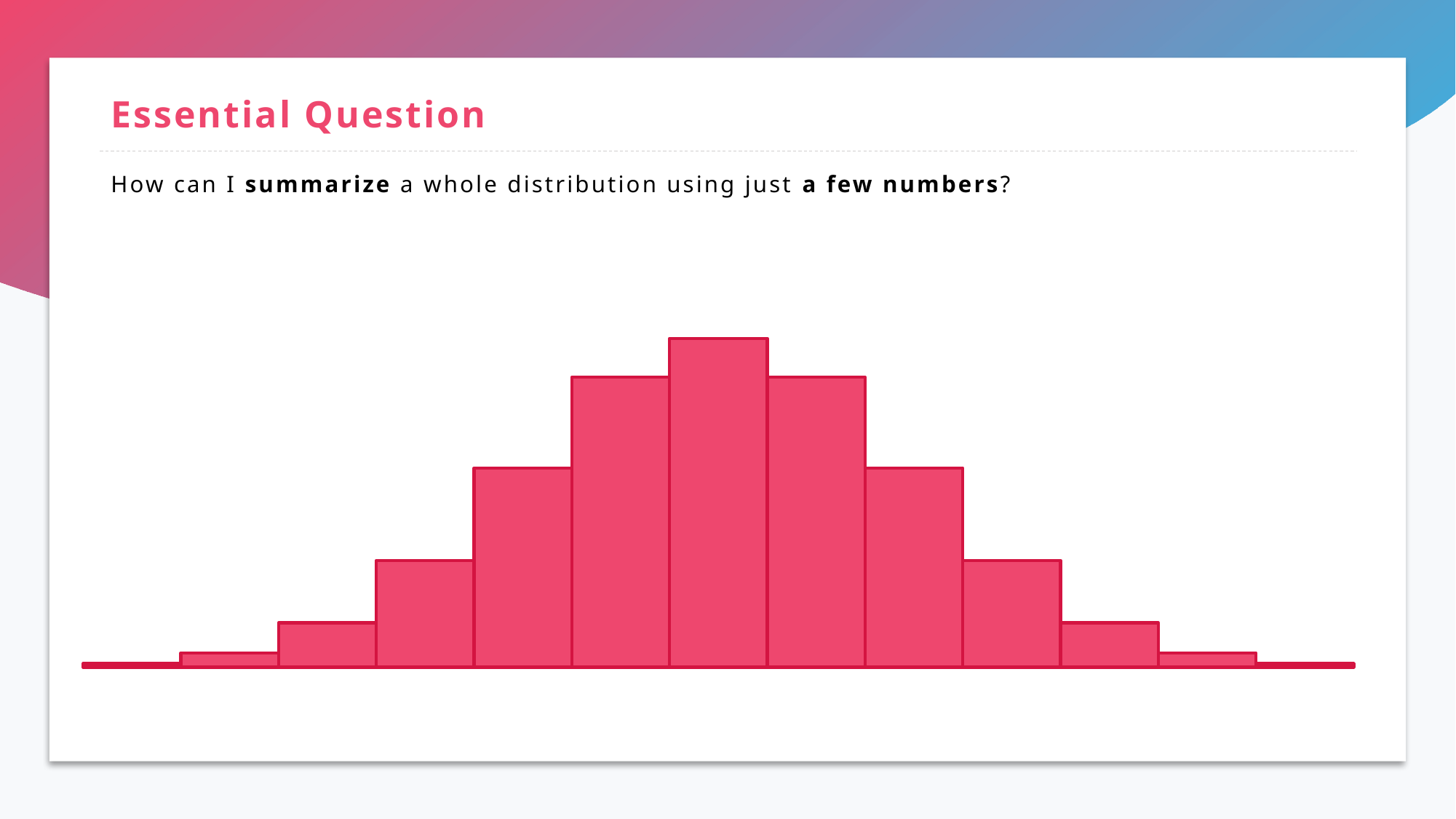
Do the bar heights rise or fall moving from the middle of the chart toward the right edge? Fall How many bars does the chart contain? 11 What colour are the bars in the chart? Pink/red Is the fourth bar from the left taller or shorter than the third bar from the left? Taller What kind of chart is shown on the slide? Bar chart Do the bar heights rise or fall moving from the left edge toward the middle of the chart? Rise Does the chart display any axis labels or data values? No Which bars are the shortest in the chart? The leftmost and rightmost bars Which bar is the tallest in the chart? The middle (sixth) bar Is the eighth bar from the left taller or shorter than the ninth bar from the left? Taller